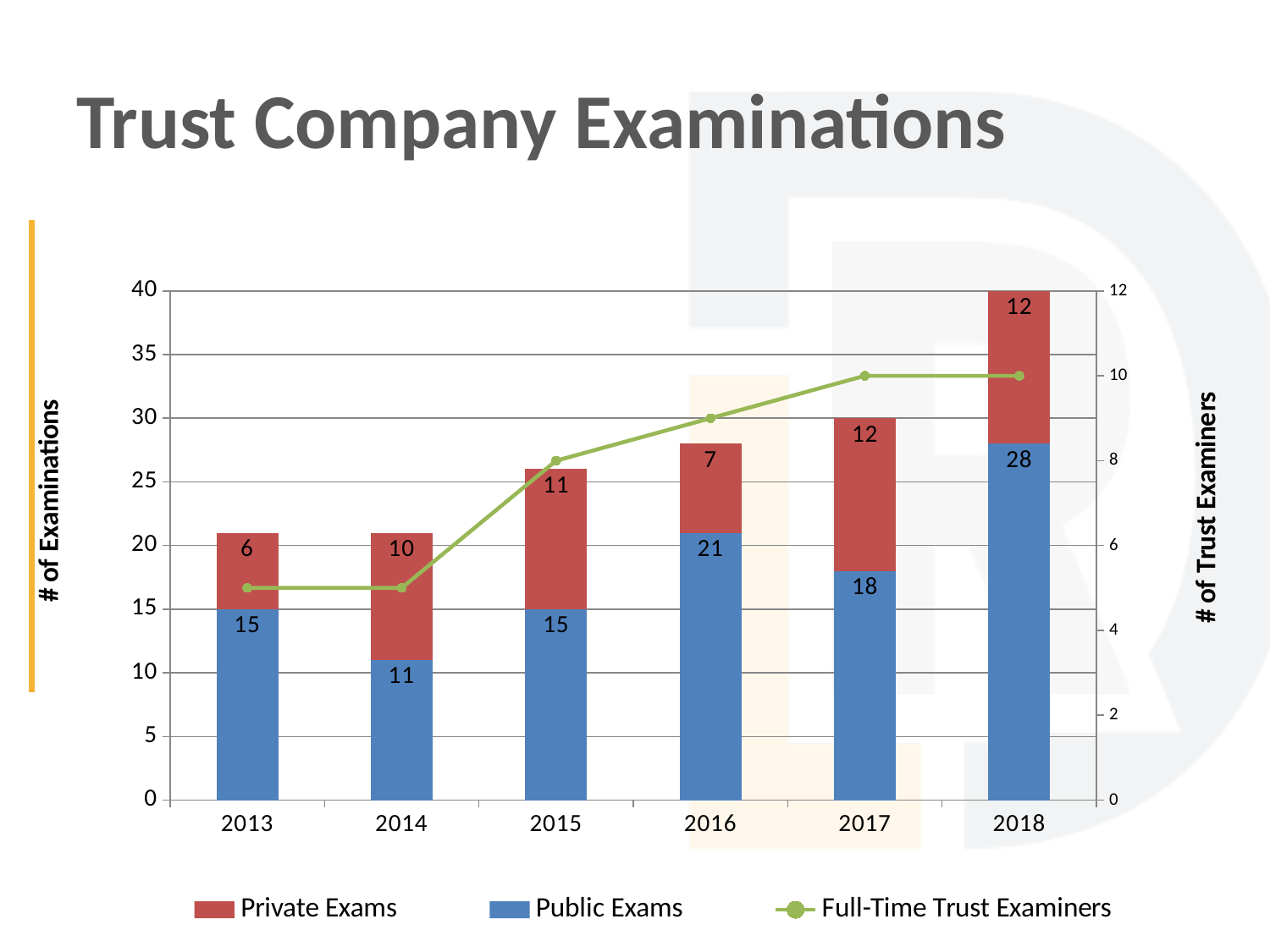
What is the total of the stacked bar for 2018? 40 What is the value for Private Exams in 2014? 10 Which is larger, Private Exams in 2015 or Private Exams in 2016? Private Exams in 2015 What is the value for Public Exams in 2016? 21 How many series does the legend list? 3 What is the difference between Public Exams in 2018 and Public Exams in 2017? 10 Which year has the lowest value for Private Exams? 2013 Is the value for Full-Time Trust Examiners in 2013 greater or less than 6 on the right axis? less What is the total of the stacked bar for 2015? 26 How many years are shown on the x axis? 6 What is the value for Public Exams in 2018? 28 Which year has the highest value for Public Exams? 2018